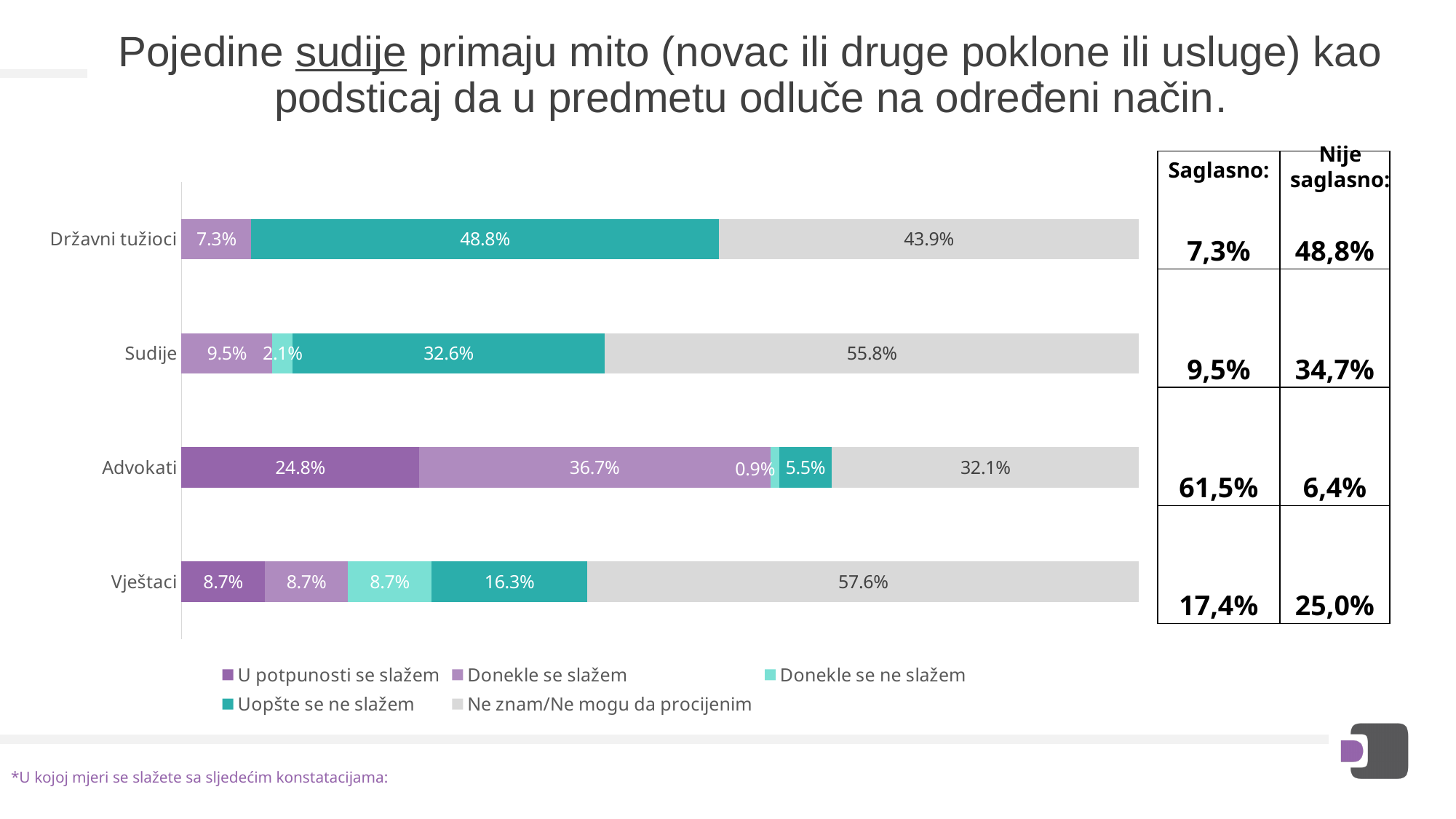
What is the value of 'Uopšte se ne slažem' for Državni tužioci? 48.8% How many categories (respondent groups) are shown on the chart? 4 What is the value of 'Donekle se ne slažem' for Vještaci? 8.7% How many series does the chart legend list? 5 Which category has the highest value for 'Ne znam/Ne mogu da procijenim'? Vještaci Which category has the lowest value for 'Ne znam/Ne mogu da procijenim'? Advokati Which legend entry is shown in the lightest grey colour? Ne znam/Ne mogu da procijenim Which is larger: 'Donekle se slažem' for Advokati or 'Donekle se slažem' for Sudije? Advokati What is the difference between the 'Uopšte se ne slažem' values for Državni tužioci and Sudije? 16.2 percentage points What kind of chart is shown on the slide? Stacked bar chart What is the value of 'U potpunosti se slažem' for Advokati? 24.8% What is the value of 'Ne znam/Ne mogu da procijenim' for Sudije? 55.8%